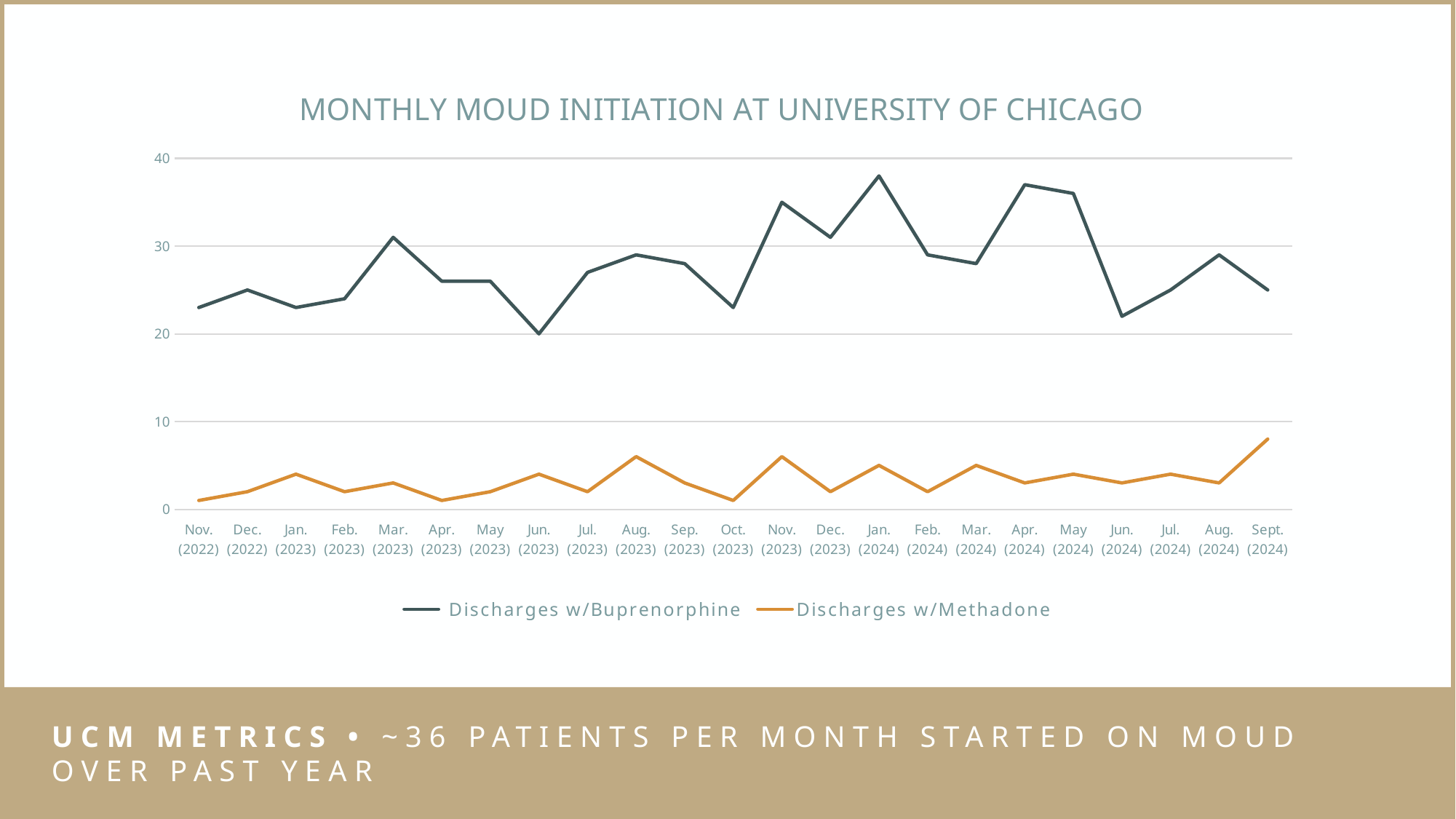
How many series does the legend list? 2 Is the value for Discharges w/Buprenorphine in Oct. (2023) greater or less than 30? less In which month is the value for Discharges w/Buprenorphine lowest? Jun. (2023) Does the value for Discharges w/Buprenorphine rise or fall from Jun. (2023) to Aug. (2023)? rise Which is larger in Aug. (2023): Discharges w/Buprenorphine or Discharges w/Methadone? Discharges w/Buprenorphine Is the value for Discharges w/Buprenorphine in Nov. (2023) greater or less than 30? greater In which month is the value for Discharges w/Methadone highest? Sept. (2024) How many months are plotted along the x axis? 23 What kind of chart is shown on the slide? Line chart In which month is the value for Discharges w/Buprenorphine highest? Jan. (2024) Is the value for Discharges w/Methadone in Sept. (2024) greater or less than 10? less What is the title of the chart? MONTHLY MOUD INITIATION AT UNIVERSITY OF CHICAGO